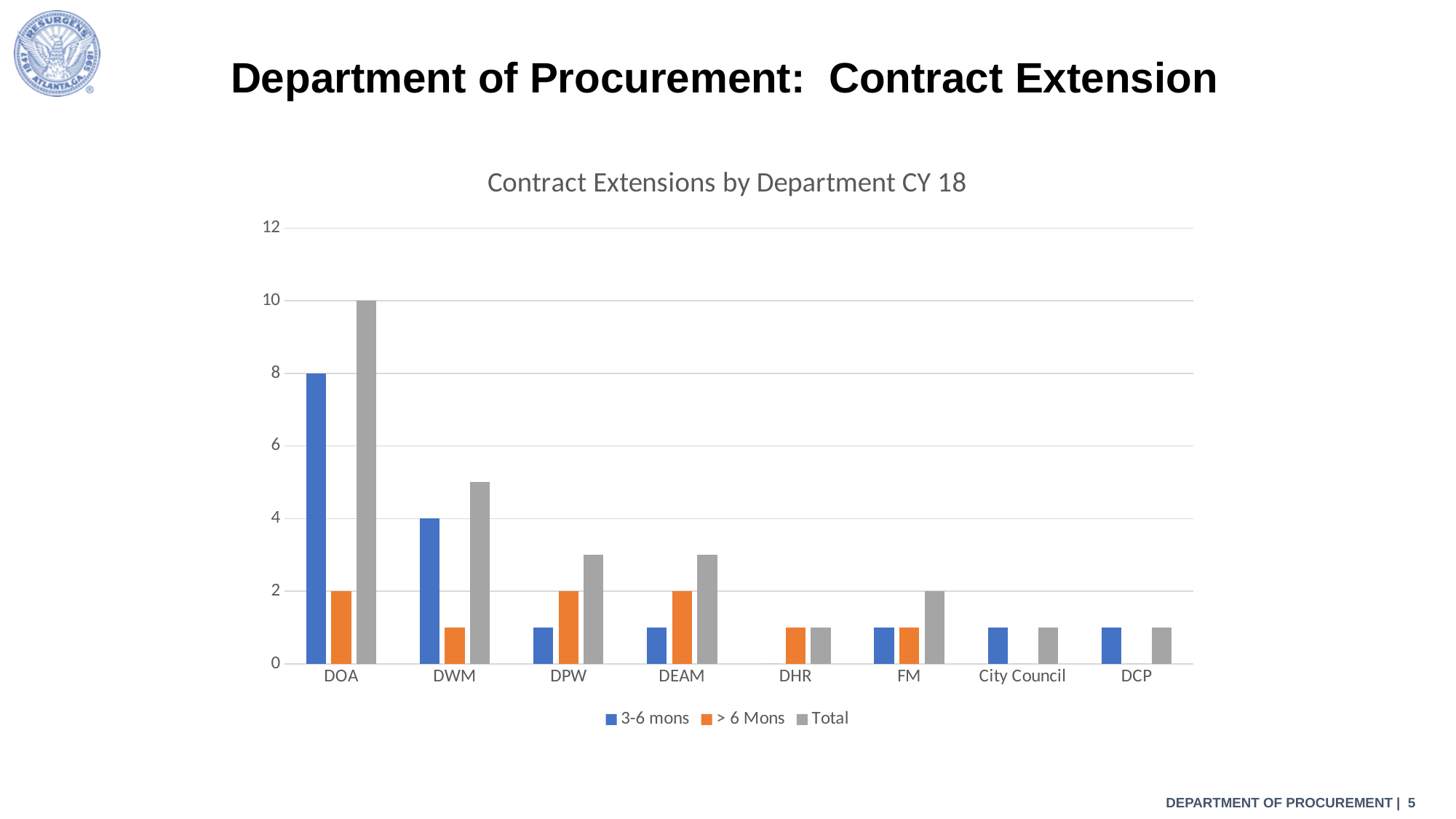
Which department has the highest Total value? DOA What kind of chart is shown on the slide? Bar chart How many series does the legend list? 3 What is the Total value for DOA? 10 What is the 3-6 mons value for DWM? 4 Which is larger for DOA, the 3-6 mons value or the > 6 Mons value? 3-6 mons How many departments are shown on the x axis? 8 What is the > 6 Mons value for DPW? 2 Is the Total value for DWM greater or less than 4? greater What is the 3-6 mons value for DOA? 8 Is the 3-6 mons value for DPW greater or less than 2? less What is the difference between the Total and the 3-6 mons values for DOA? 2